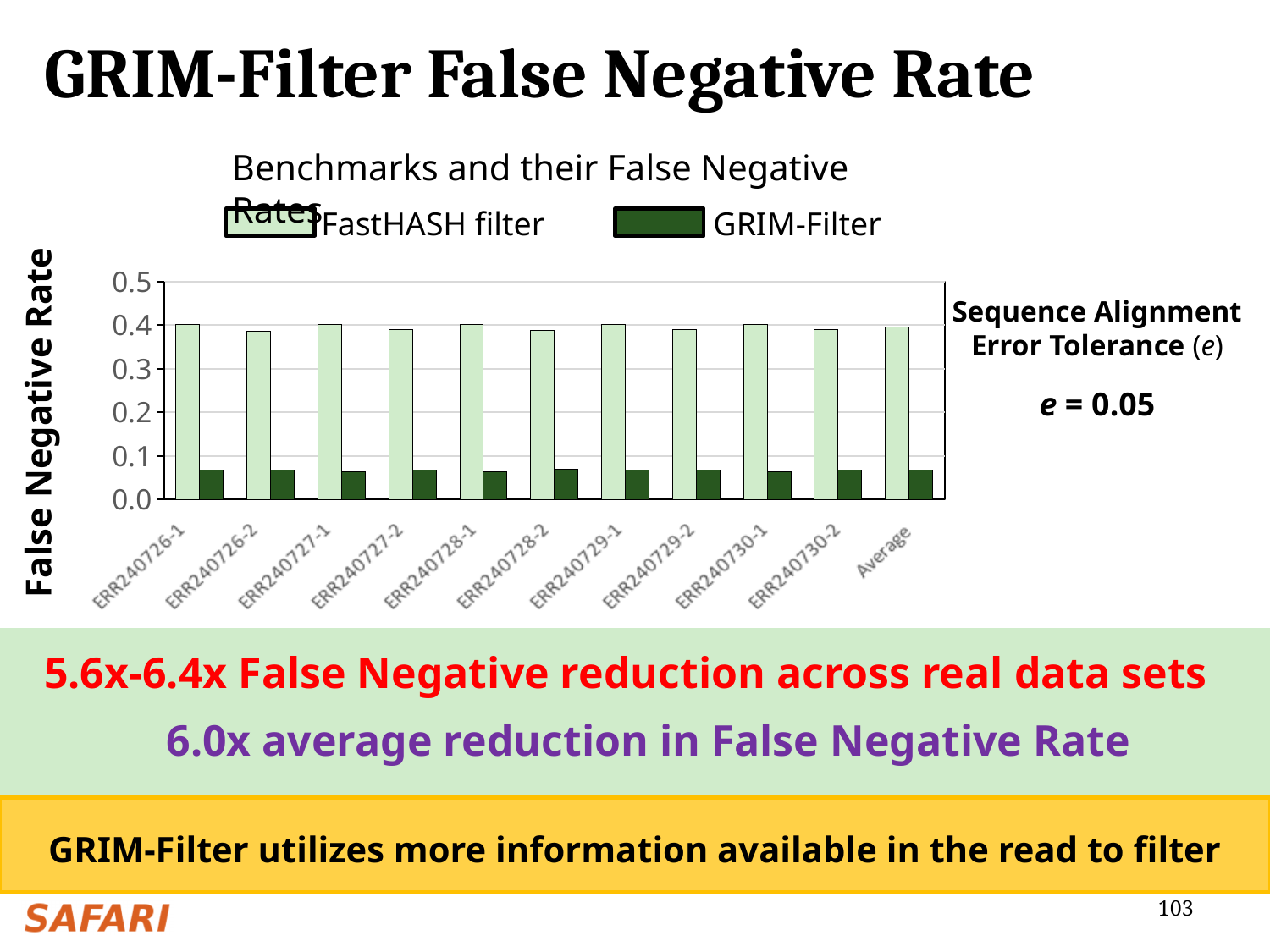
What is the label on the y axis of the chart? False Negative Rate For ERR240727-1, which series has the larger value: FastHASH filter or GRIM-Filter? FastHASH filter How many categories are shown along the x axis of the chart? 11 For Average, which series has the smaller value: FastHASH filter or GRIM-Filter? GRIM-Filter Is the FastHASH filter value for Average greater or less than 0.5? less Is the FastHASH filter value for ERR240726-1 greater or less than 0.3? greater Is the GRIM-Filter value for Average greater or less than 0.1? less How many series does the chart's legend list? 2 Which series is shown with the dark green bars in the chart? GRIM-Filter What kind of chart is shown on the slide? bar chart